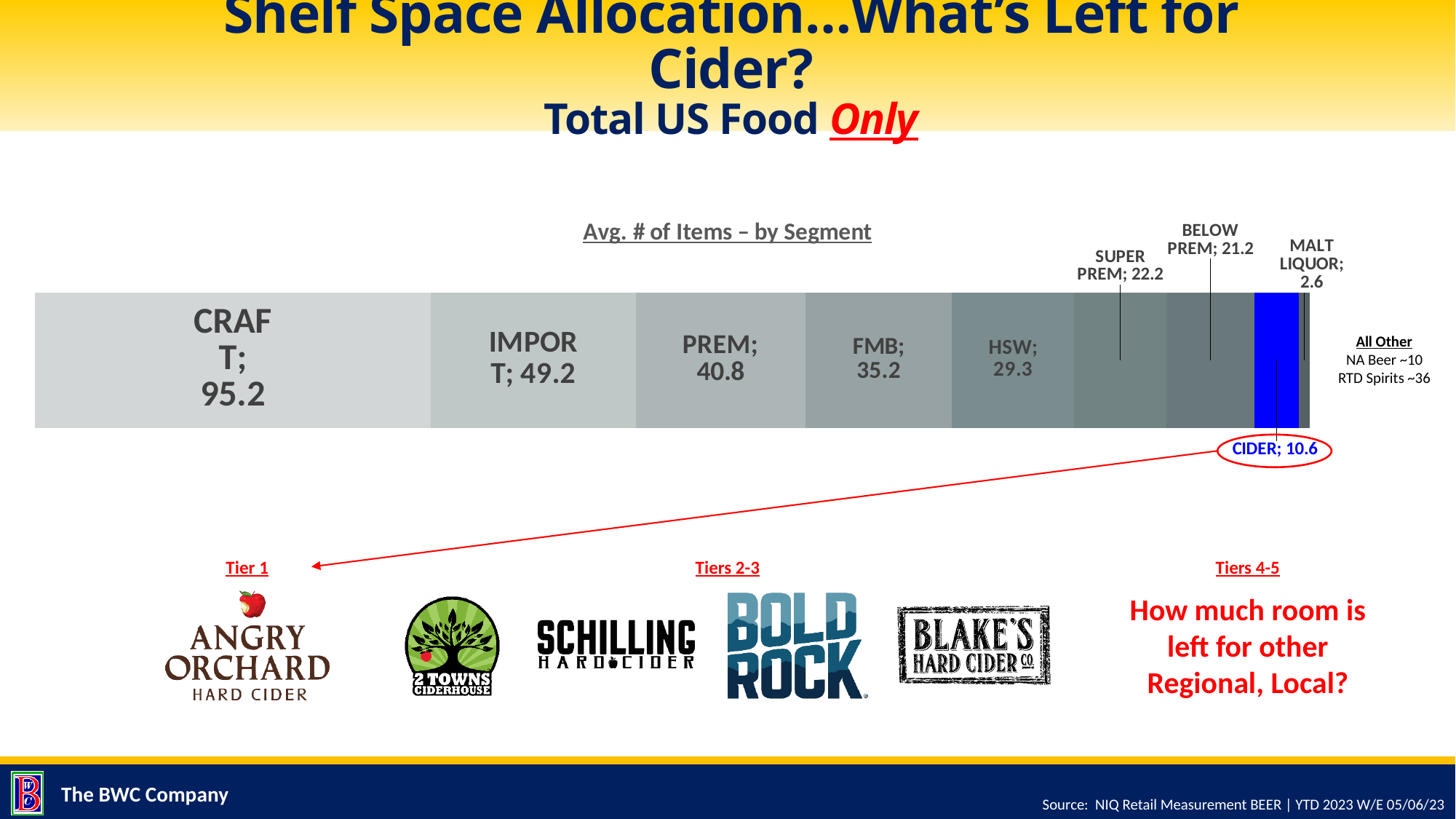
What is the value for the BELOW PREM segment? 21.2 Which segment has the highest average number of items? CRAFT What kind of chart is shown on the slide? Stacked bar chart What is the average number of items for CIDER? 10.6 What is the difference between the SUPER PREM and BELOW PREM values? 1 What is the title of the chart? Avg. # of Items – by Segment What is the difference between the CRAFT and IMPORT values? 46 Which segment has the lowest average number of items? MALT LIQUOR What is the average number of items for the CRAFT segment? 95.2 Which is larger, the value for FMB or the value for HSW? FMB What value is shown for the MALT LIQUOR segment? 2.6 How many segments are shown in the bar? 9